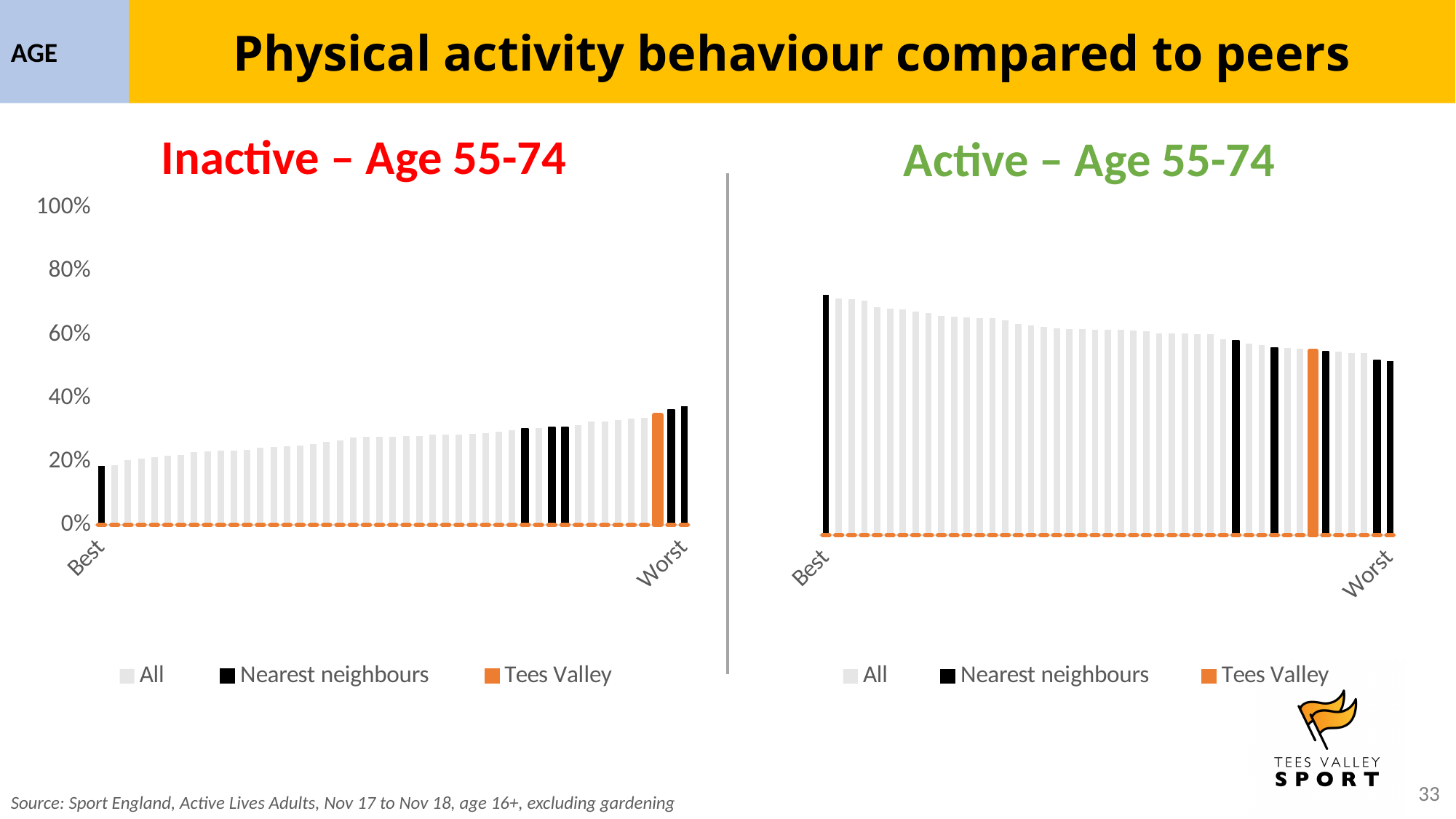
In the "Active – Age 55-74" chart, is the Tees Valley value greater or less than 40%? greater In the "Active – Age 55-74" chart, is the value of the Best bar greater or less than 60%? greater In the "Inactive – Age 55-74" chart, is the Tees Valley value greater or less than 40%? less In the "Inactive – Age 55-74" chart, which colour represents Tees Valley in the legend? orange In the "Inactive – Age 55-74" chart, do the bars rise or fall from Best to Worst? rise Is the Tees Valley bar higher in the "Inactive – Age 55-74" chart or the "Active – Age 55-74" chart? Active – Age 55-74 What type of chart is the "Inactive – Age 55-74" chart? bar chart How many series does the legend of the "Active – Age 55-74" chart list? 3 What is the title of the chart on the right of the slide? Active – Age 55-74 In the "Active – Age 55-74" chart, do the bars rise or fall from Best to Worst? fall